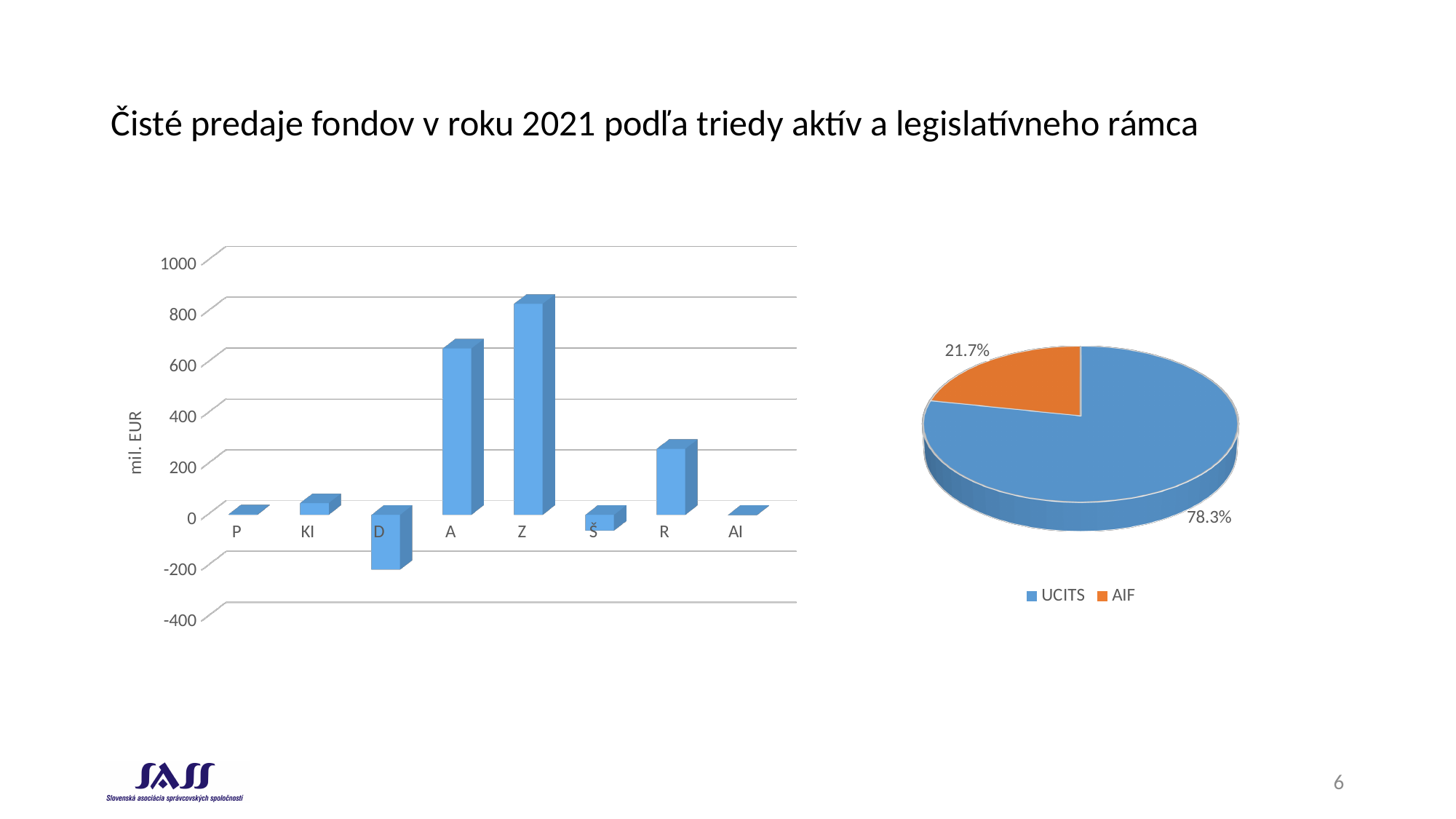
On the left bar chart, which is larger, the value for A or the value for R? A On the right pie chart, what share does UCITS have? 78.3% On the left bar chart, is the value for R greater or less than 400? less On the left bar chart, is the value for A greater or less than 400? greater What kind of chart is the chart on the left of the slide? bar chart On the right pie chart, what share does AIF have? 21.7% On the left bar chart, is the value for D greater or less than 0? less What is the y-axis label on the left bar chart? mil. EUR How many categories are shown on the left bar chart? 8 On the left bar chart, which category has the lowest value? D On the left bar chart, which category has the highest value? Z